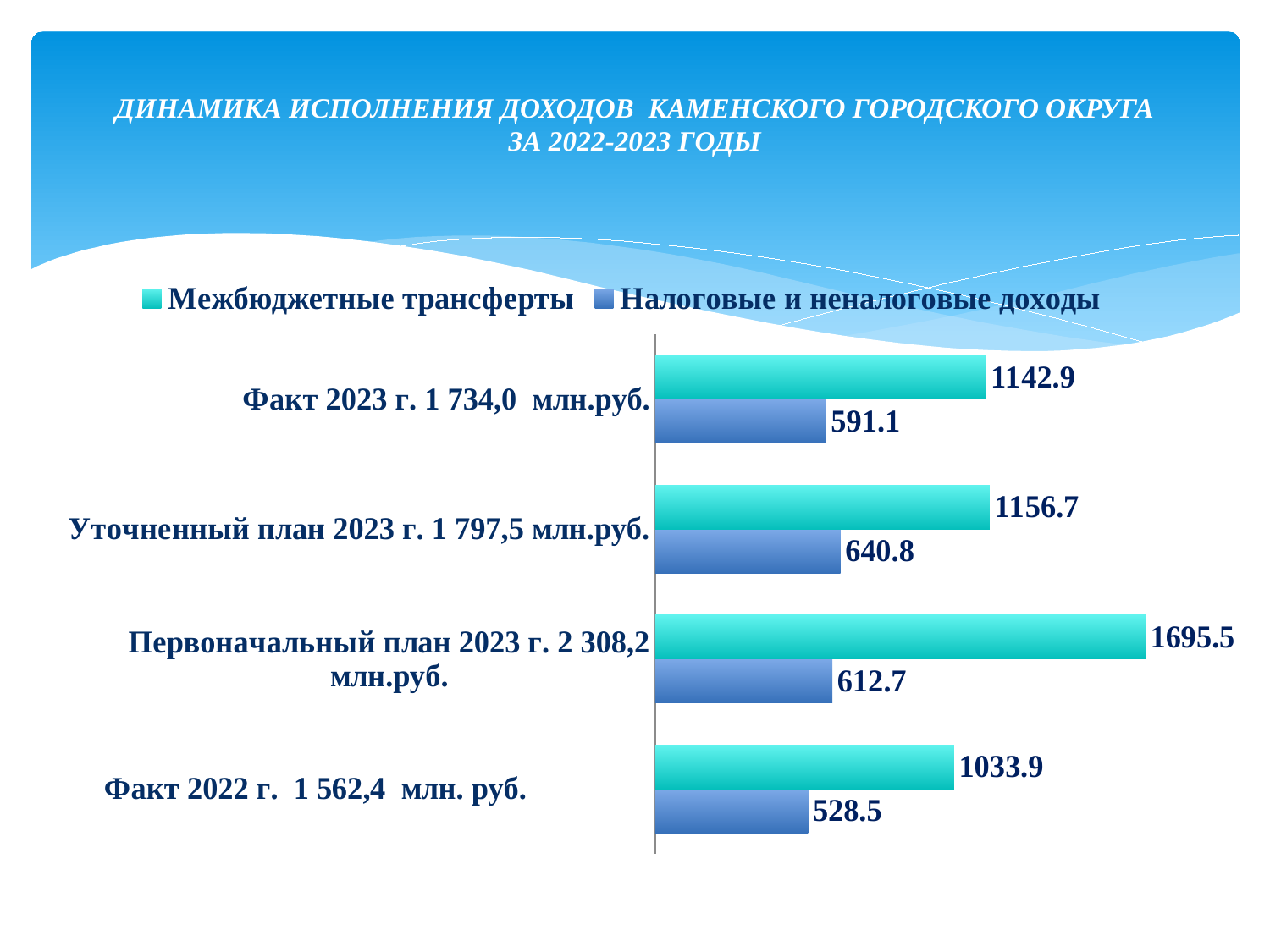
What is the difference between Межбюджетные трансферты for Первоначальный план 2023 г. and Уточненный план 2023 г.? 538.8 Which is larger: Налоговые и неналоговые доходы for Первоначальный план 2023 г. or for Факт 2023 г.? Первоначальный план 2023 г. How many categories are shown on the chart? 4 How many series does the legend list? 2 Which series is shown in teal (green-blue) colour in the legend? Межбюджетные трансферты What is the difference between Налоговые и неналоговые доходы for Уточненный план 2023 г. and Факт 2023 г.? 49.7 What is the value of Межбюджетные трансферты for Факт 2023 г.? 1142.9 What type of chart is shown on the slide? bar chart Which category has the highest value for Межбюджетные трансферты? Первоначальный план 2023 г. 2 308,2 млн.руб. Which category has the lowest value for Налоговые и неналоговые доходы? Факт 2022 г. 1 562,4 млн. руб. What is the value of Налоговые и неналоговые доходы for Факт 2022 г.? 528.5 What is the value of Налоговые и неналоговые доходы for Уточненный план 2023 г.? 640.8